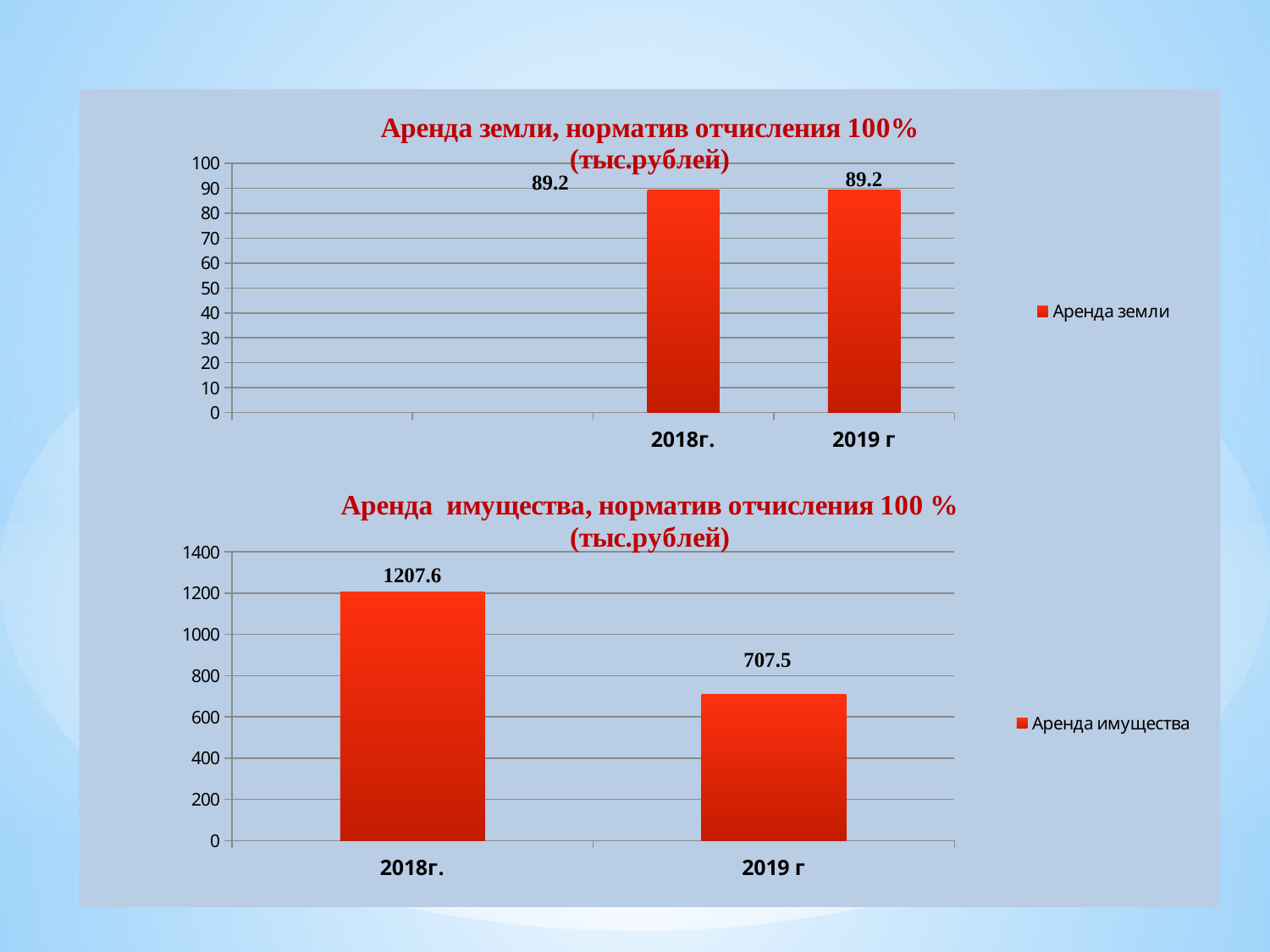
What kind of chart is the bottom chart (Аренда имущества)? bar chart What is the legend entry of the top chart? Аренда земли How many categories are shown in the top chart (Аренда земли)? 2 In the top chart (Аренда земли), what is the value for 2019 г? 89.2 In the bottom chart (Аренда имущества), which year has the lowest value? 2019 г In the bottom chart (Аренда имущества), which year has the highest value? 2018г. In the bottom chart (Аренда имущества), what is the difference between the 2018г. and 2019 г values? 500.1 In the bottom chart (Аренда имущества), what is the value for 2018г.? 1207.6 In the bottom chart (Аренда имущества), do the values rise or fall from 2018г. to 2019 г? fall In the bottom chart (Аренда имущества), what is the value for 2019 г? 707.5 In the top chart (Аренда земли), what is the value for 2018г.? 89.2 In the bottom chart (Аренда имущества), is the value for 2019 г greater or less than 800? less